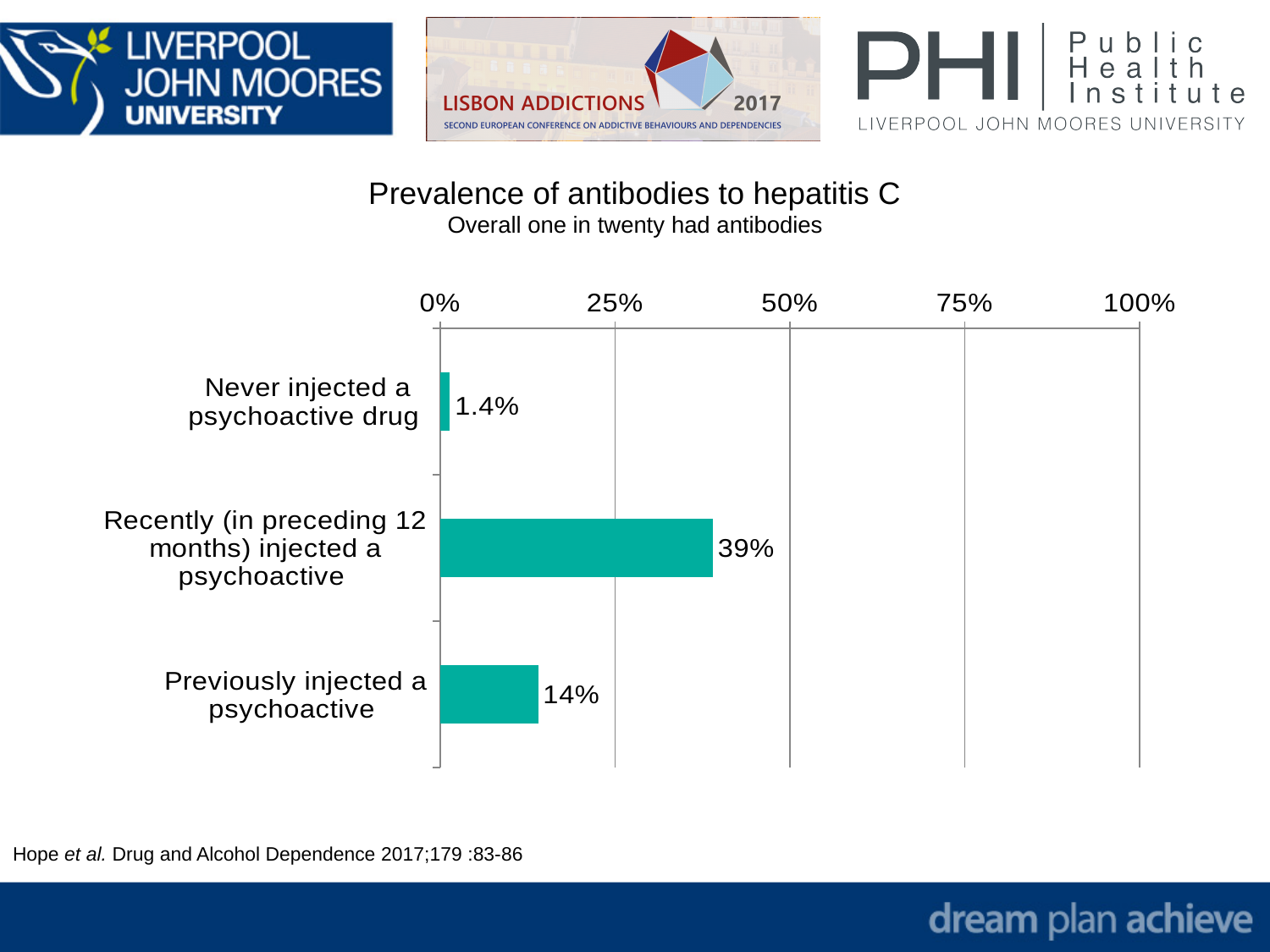
What is the difference in prevalence between those who recently injected a psychoactive and those who previously injected a psychoactive? 25% Which is larger: the prevalence for those who previously injected a psychoactive or for those who never injected a psychoactive drug? Previously injected a psychoactive What is the maximum value shown on the chart's axis? 100% Which category has the lowest prevalence of hepatitis C antibodies? Never injected a psychoactive drug What kind of chart is shown on the slide? Bar chart What is the prevalence of hepatitis C antibodies among those who recently (in preceding 12 months) injected a psychoactive? 39% How many categories are shown in the chart? 3 What is the title of the chart? Prevalence of antibodies to hepatitis C What is the prevalence of hepatitis C antibodies among those who never injected a psychoactive drug? 1.4% Is the value for those who recently injected a psychoactive greater or less than 50%? less Which category has the highest prevalence of hepatitis C antibodies? Recently (in preceding 12 months) injected a psychoactive What is the prevalence of hepatitis C antibodies among those who previously injected a psychoactive? 14%